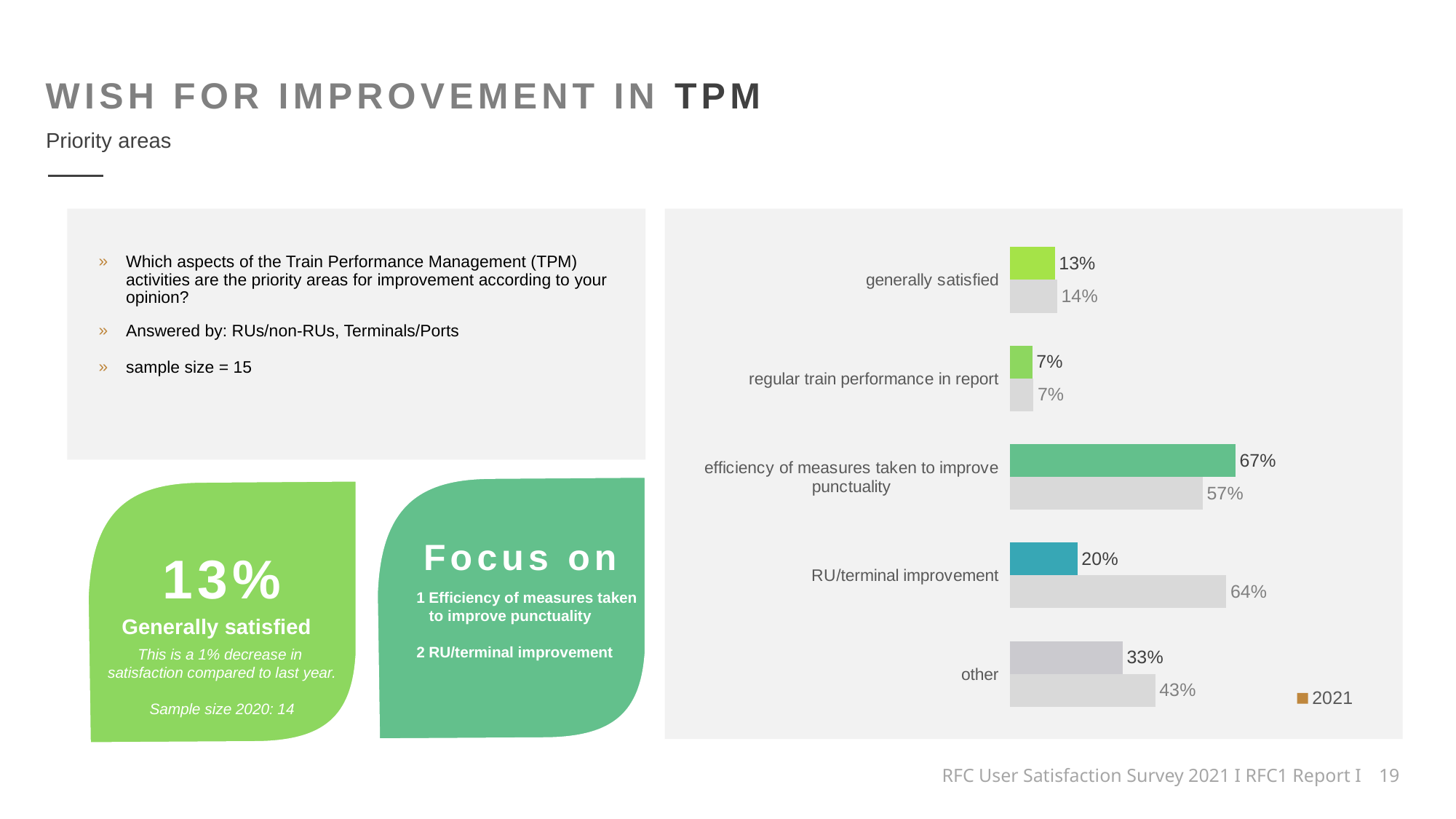
What is the 2021 value for "RU/terminal improvement"? 20% What is the 2021 value for "efficiency of measures taken to improve punctuality"? 67% What kind of chart is shown on the slide? bar chart What is the difference between the 2021 bar and the grey bar for "RU/terminal improvement"? 44% Which category has the highest 2021 value? efficiency of measures taken to improve punctuality What value is shown on the grey (lower) bar for "other"? 43% Which category has the lowest 2021 value? regular train performance in report How many categories are shown on the chart? 5 For "other", which is larger: the 2021 bar or the grey bar? the grey bar Which series is named in the chart legend? 2021 What value is shown on the grey (lower) bar for "generally satisfied"? 14% What is the difference between the 2021 bar and the grey bar for "efficiency of measures taken to improve punctuality"? 10%